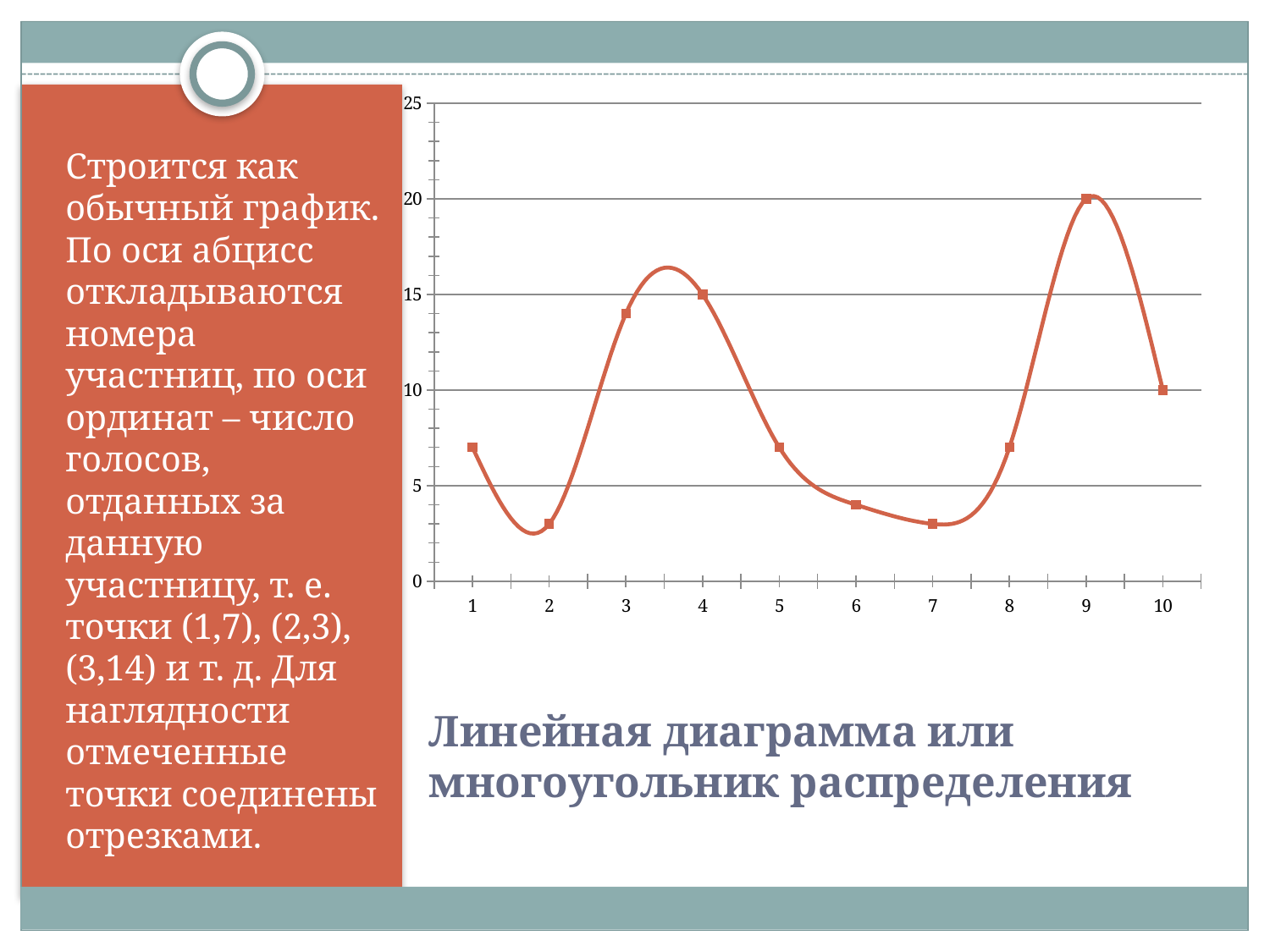
What is the value at x = 10? 10 What kind of chart is shown on the slide? line chart Which is larger, the value at x = 9 or the value at x = 4? 9 What is the difference between the values at x = 9 and x = 10? 10 Is the value at x = 5 greater or less than 5? greater What is the value at x = 9? 20 What is the value at x = 4? 15 Does the line rise or fall from x = 8 to x = 9? rise What is the title given below the chart? Линейная диаграмма или многоугольник распределения How many points are plotted on the chart? 10 Which x-axis category has the highest value on the chart? 9 Is the value at x = 7 greater or less than 5? less